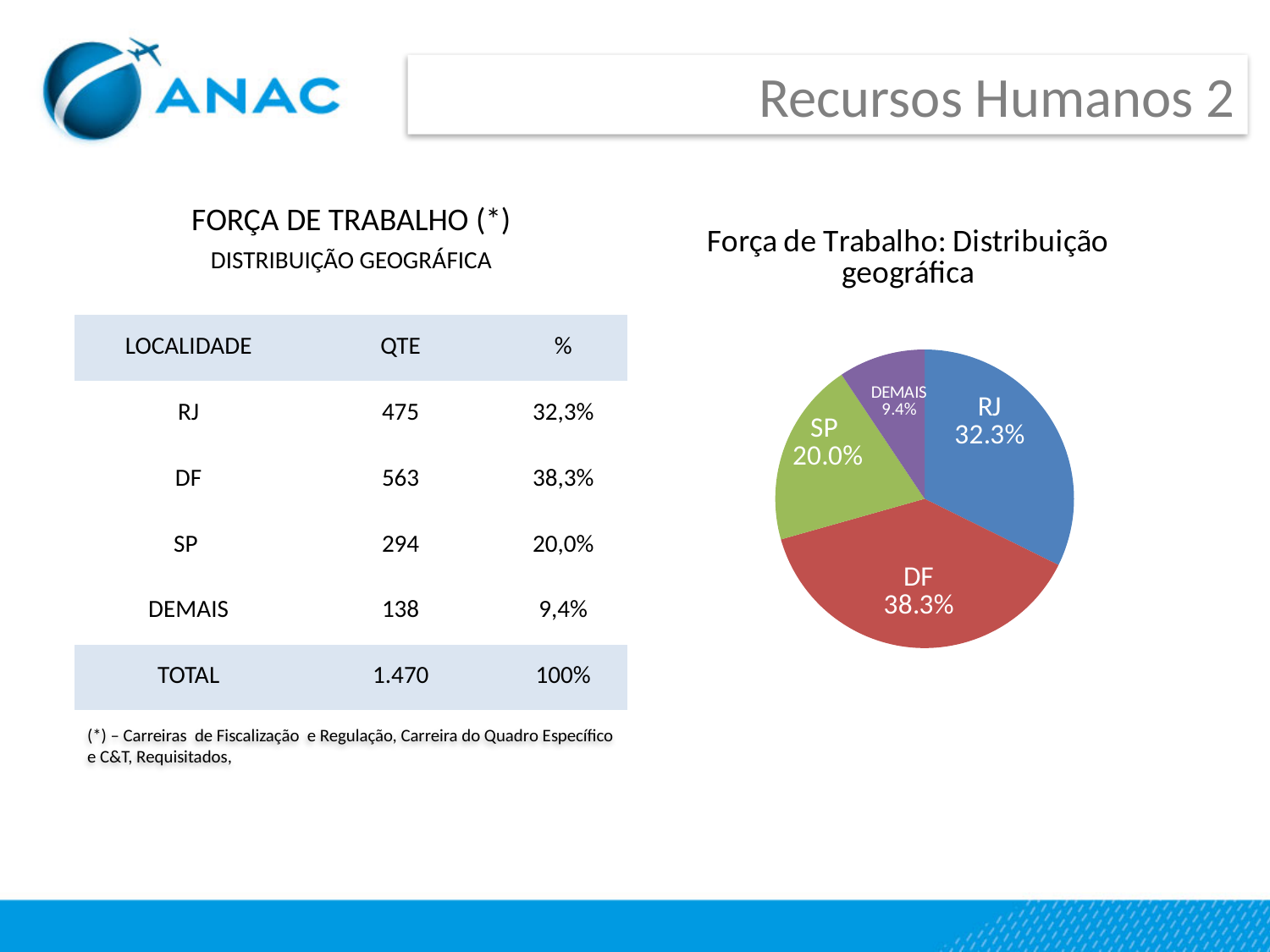
What share of the pie does RJ represent? 32.3% How many slices does the pie chart have? 4 What share of the pie does DEMAIS represent? 9.4% What is the difference in percentage points between the DF and RJ slices? 6.0 What kind of chart is shown on the slide? pie chart What share of the pie does DF represent? 38.3% Which slice of the pie chart is the smallest? DEMAIS Which slice is larger in the pie chart, RJ or SP? RJ Which slice of the pie chart is the largest? DF What is the title of the pie chart? Força de Trabalho: Distribuição geográfica What colour is the DF slice in the pie chart? red